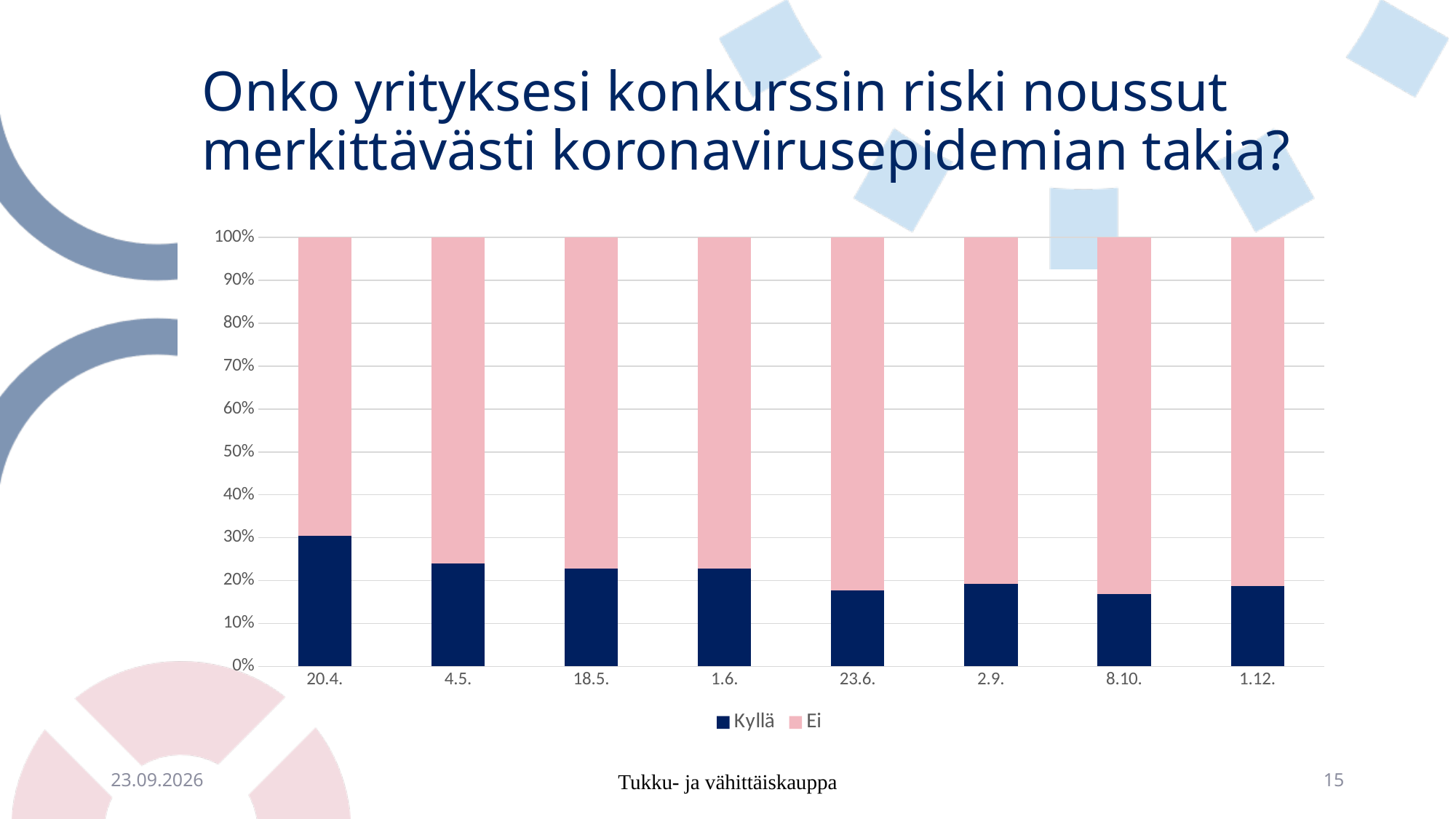
How many series does the legend list? 2 Which has a larger Kyllä share, 4.5. or 2.9.? 4.5. Is the Kyllä value for 20.4. greater or less than 20%? greater On which date is the Kyllä share the highest? 20.4. What kind of chart is shown on the slide? stacked bar chart Is the Kyllä value for 23.6. greater or less than 20%? less Does the Kyllä share generally rise or fall from 20.4. to 1.12.? fall Is the Ei value for 20.4. greater or less than 80%? less How many dates (categories) are shown on the x axis? 8 Which has a larger Kyllä share, 20.4. or 4.5.? 20.4. What are the two series named in the legend? Kyllä and Ei What is the total of each stacked bar? 100%